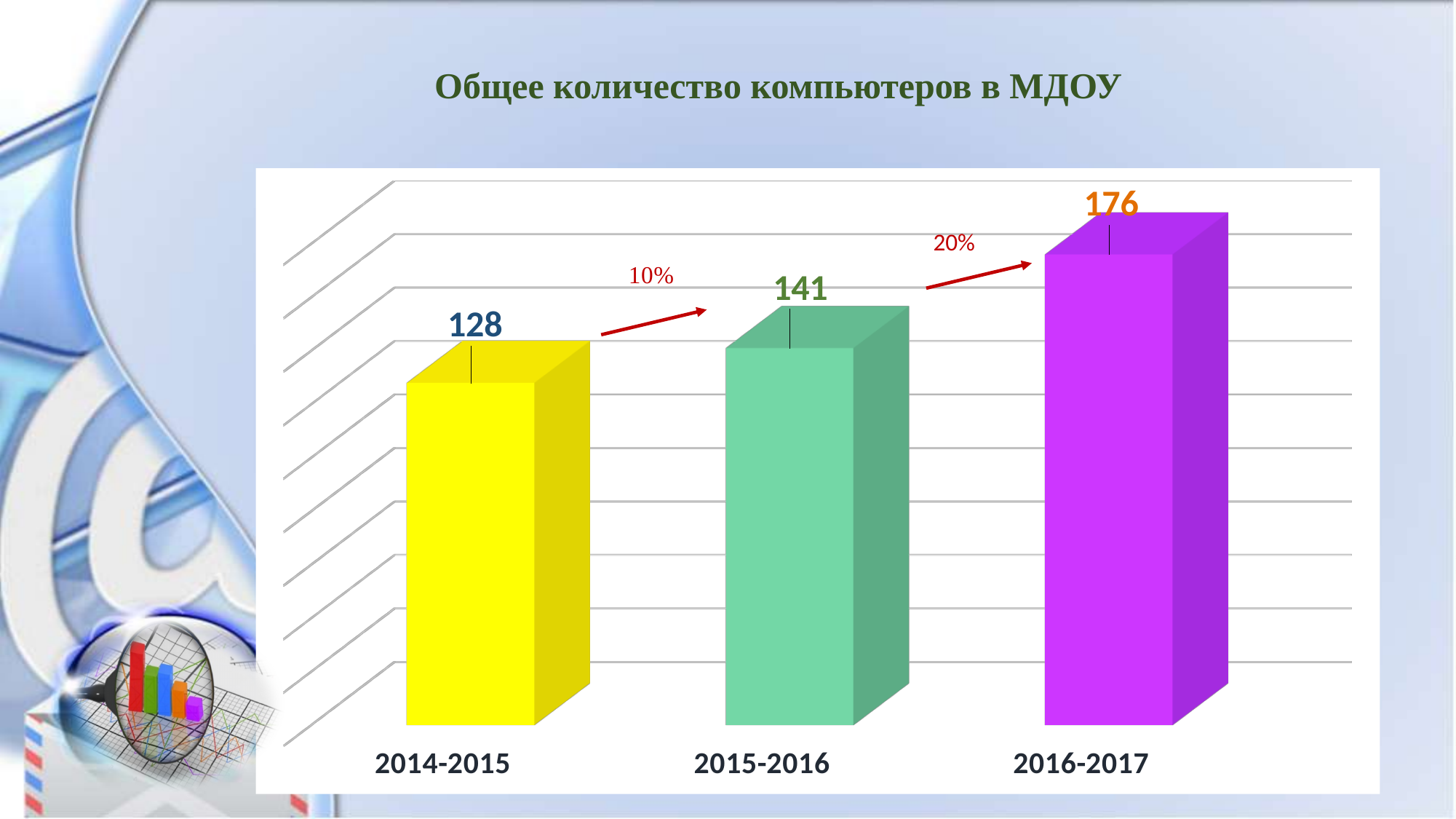
What kind of chart is shown on the slide? bar chart What is the value for 2014-2015? 128 Which period has the highest value? 2016-2017 How many periods are shown on the chart? 3 What is the difference between the values for 2015-2016 and 2014-2015? 13 What is the value for 2016-2017? 176 What is the difference between the values for 2016-2017 and 2015-2016? 35 Do the values rise or fall from 2014-2015 to 2016-2017? rise What is the title of the chart? Общее количество компьютеров в МДОУ Which is larger, the value for 2014-2015 or the value for 2015-2016? 2015-2016 Which period has the lowest value? 2014-2015 What is the value for 2015-2016? 141